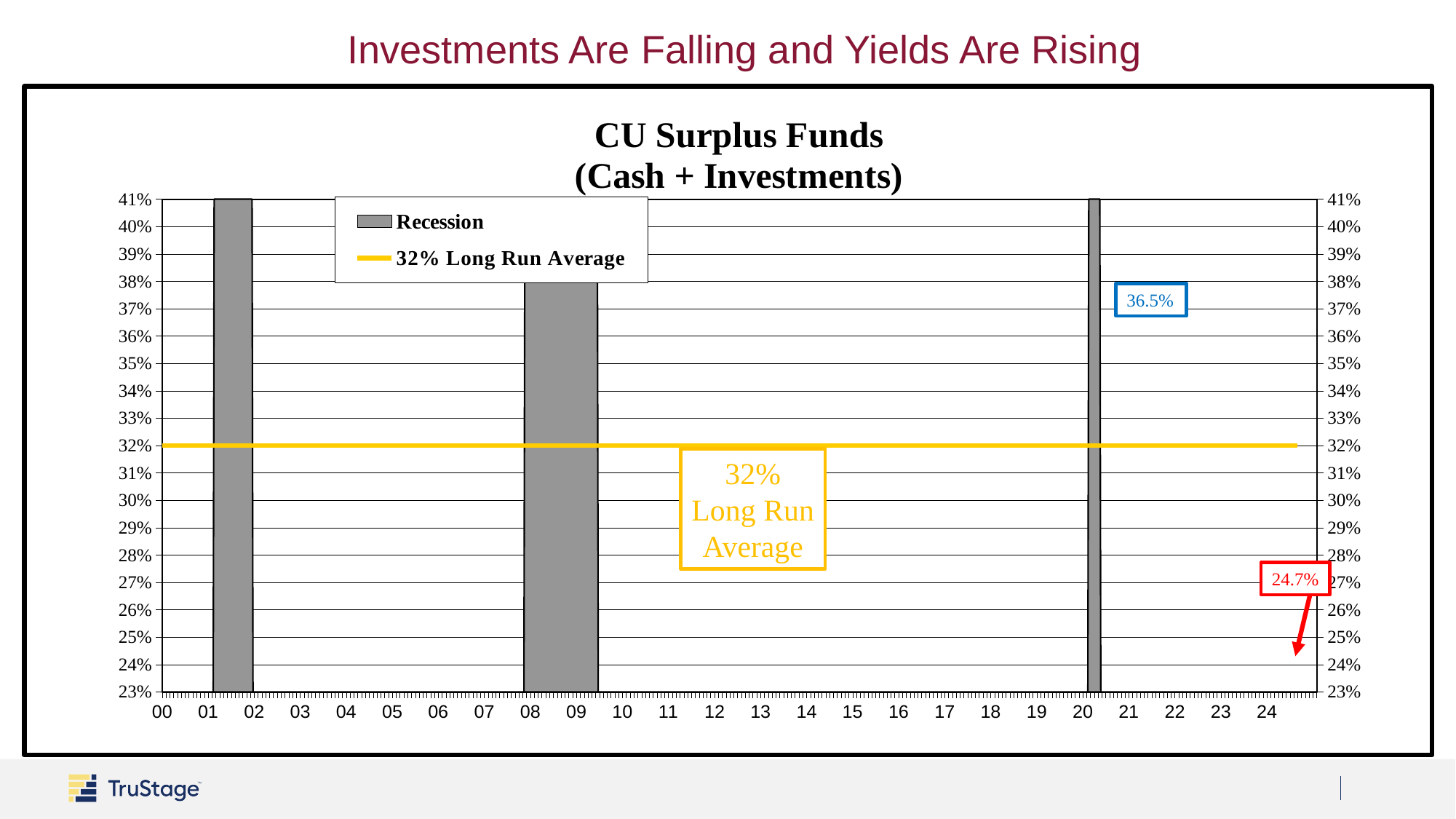
Which annotated value is larger, the one near year 21 or the one near year 24? The one near year 21 (36.5%) What value is shown in the blue annotation box near year 21? 36.5% What is the highest value shown on the vertical axis? 41% Is the annotated value 36.5% greater or less than the 32% long run average? greater What is the title of the chart? CU Surplus Funds (Cash + Investments) What value is shown in the red annotation box near year 24? 24.7% How many entries does the chart legend list? 2 How many shaded recession bars are shown on the chart? 3 Is the annotated value 24.7% greater or less than the 32% long run average? less What value is the long run average line drawn at? 32% What is the difference between the annotated values 36.5% and 24.7%? 11.8 percentage points What is the lowest value shown on the vertical axis? 23%